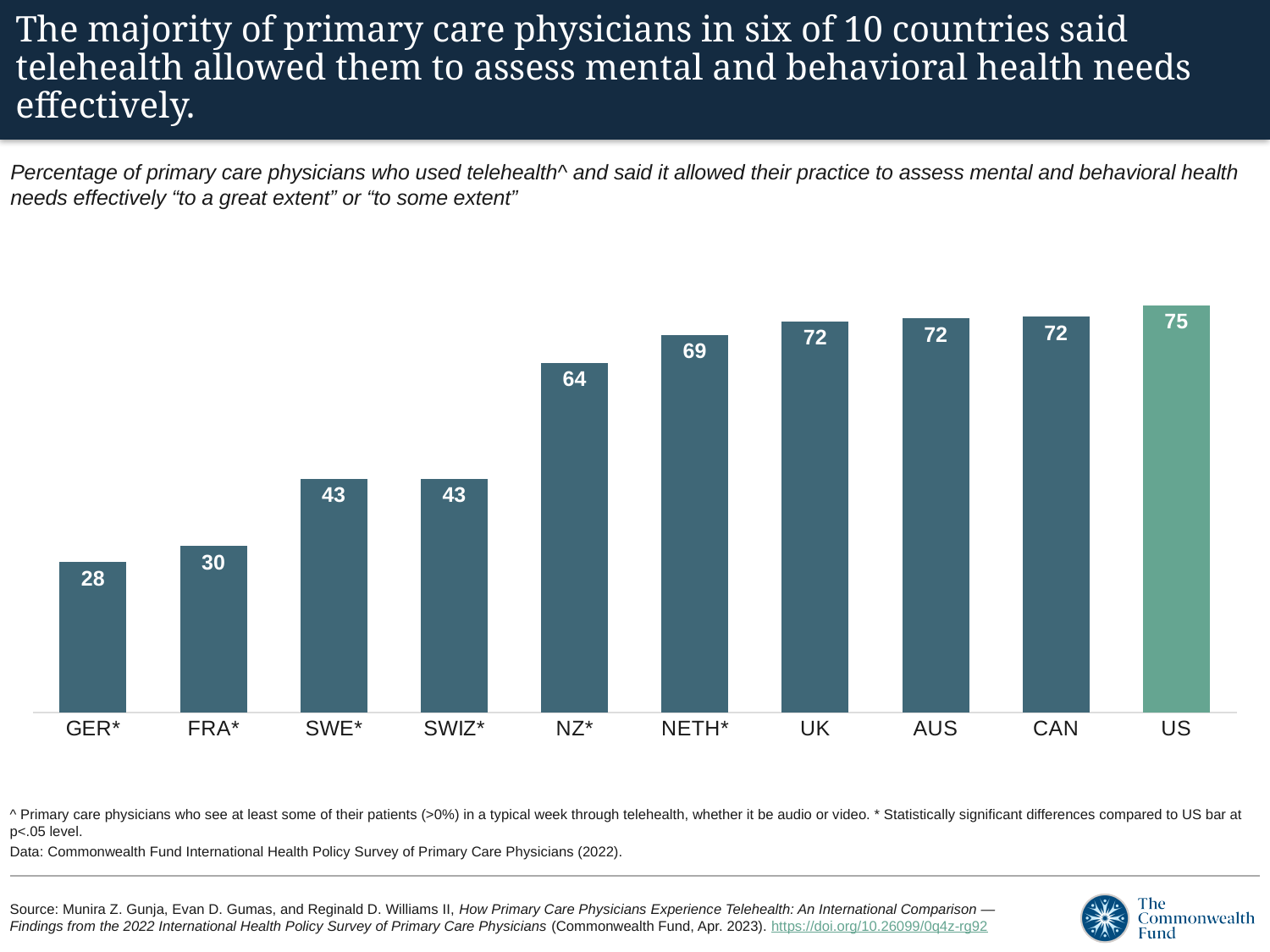
Which country has the highest value? US How many countries are shown in the chart? 10 Do the values generally rise or fall from left to right along the x axis? Rise What is the value for NZ*? 64 What is the value for NETH*? 69 What kind of chart is shown on the slide? Bar chart Which is larger, the value for FRA* or the value for SWE*? SWE* Which bar is shown in a different colour from the others? US What is the difference between the values for NETH* and NZ*? 5 What is the value for GER*? 28 What is the difference between the values for US and GER*? 47 Which country has the lowest value? GER*